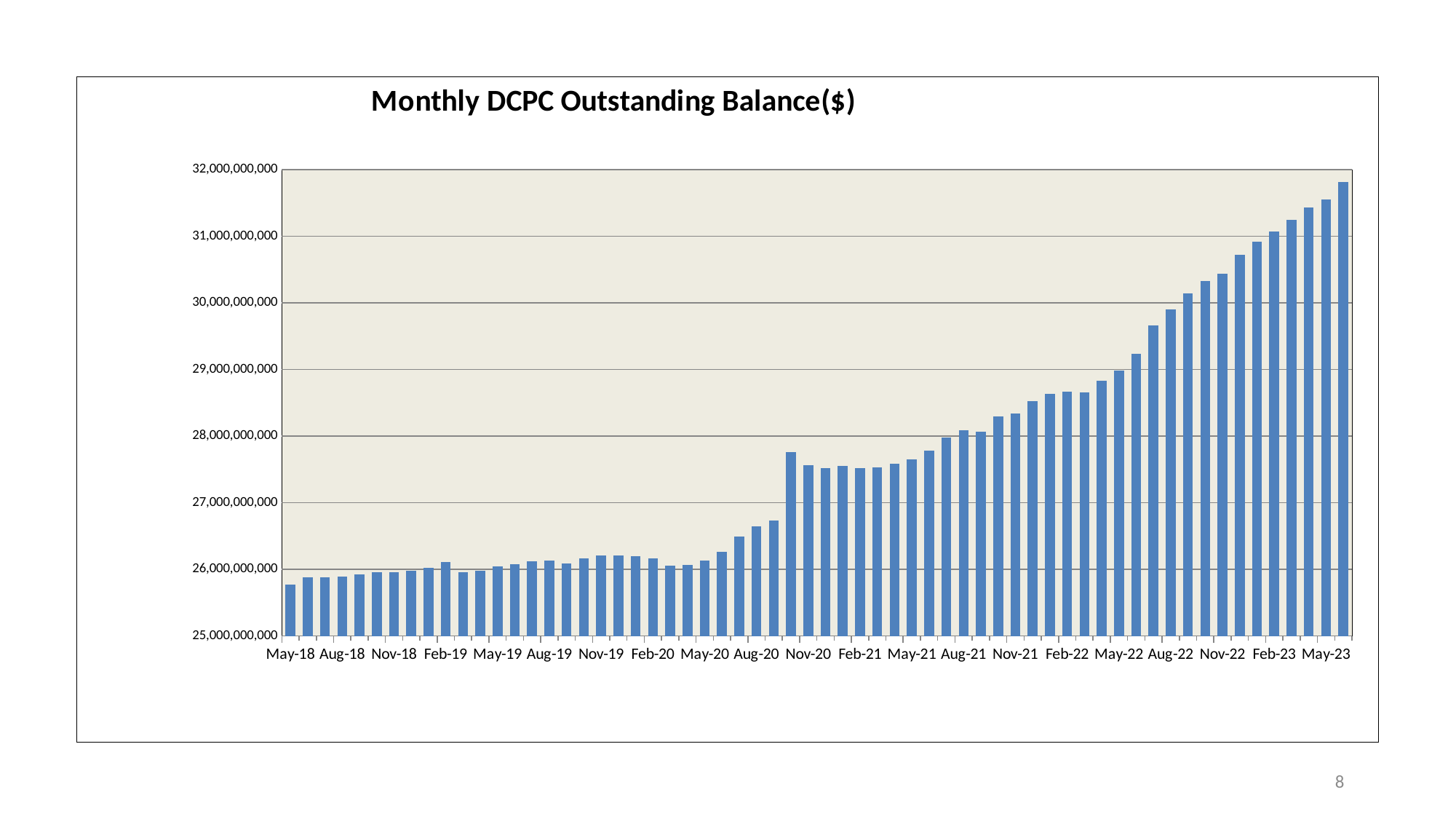
Is the value for Nov-22 greater or less than 30,000,000,000? greater Is the value for Feb-22 greater or less than 29,000,000,000? less Is the value for Aug-22 greater or less than 30,000,000,000? less What kind of chart is shown on the slide? bar chart What is the title of the chart? Monthly DCPC Outstanding Balance($) Which month has the lowest outstanding balance? May-18 Do the values generally rise or fall from May-18 to May-23? rise Which is larger, the value for Aug-20 or the value for Nov-20? Nov-20